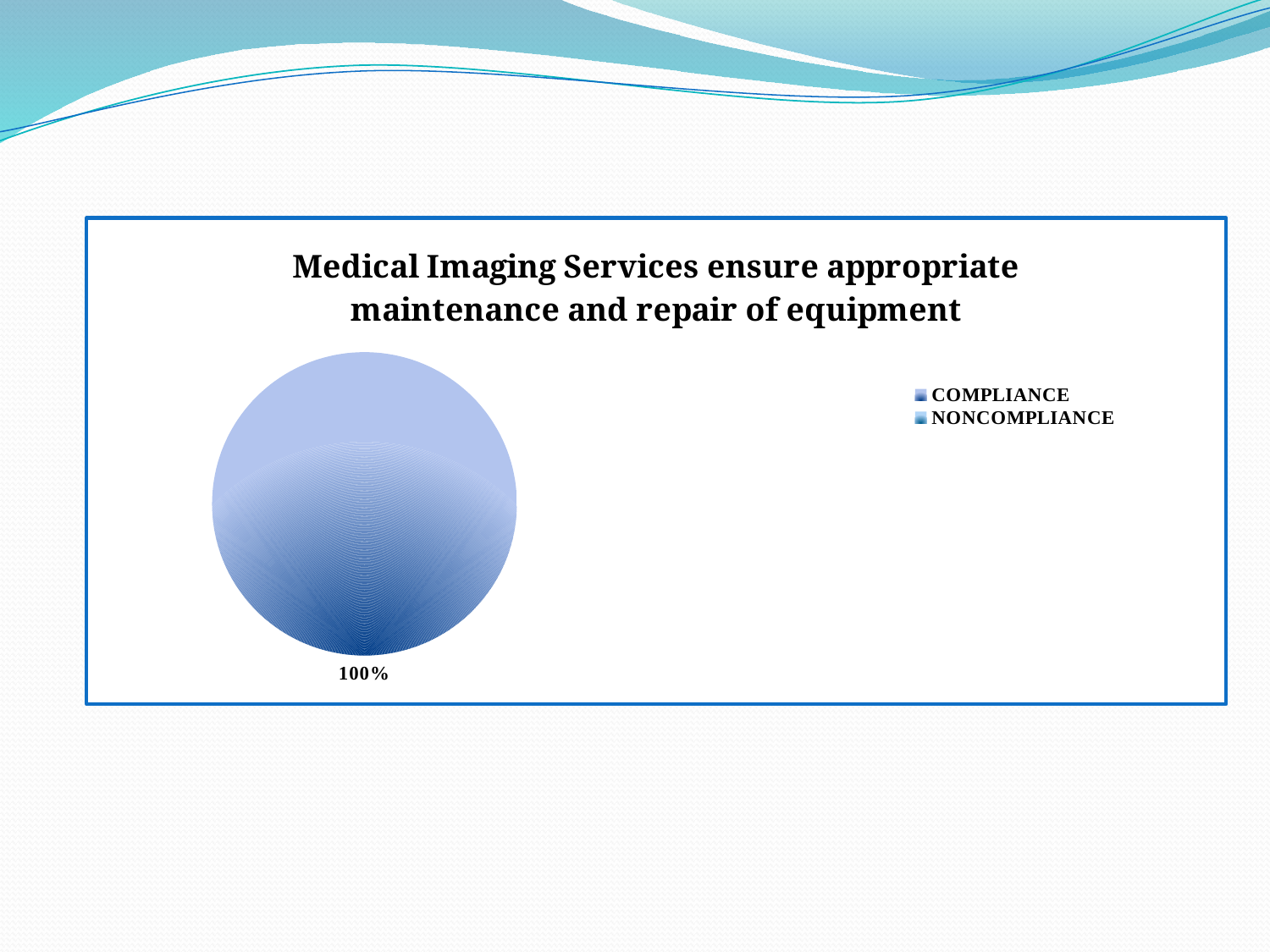
Is the share of the visible slice greater or less than 50%? greater What percentage is printed as the data label on the pie? 100% What is the value shown for COMPLIANCE? 100% Which category is larger, COMPLIANCE or NONCOMPLIANCE? COMPLIANCE Which category accounts for the entire pie? COMPLIANCE How many slices are visible in the pie chart? 1 What share of the pie does the single visible slice take up? 100% How many entries does the chart's legend list? 2 What is the title of the chart? Medical Imaging Services ensure appropriate maintenance and repair of equipment What kind of chart is shown on the slide? pie chart What are the two categories listed in the legend? COMPLIANCE and NONCOMPLIANCE